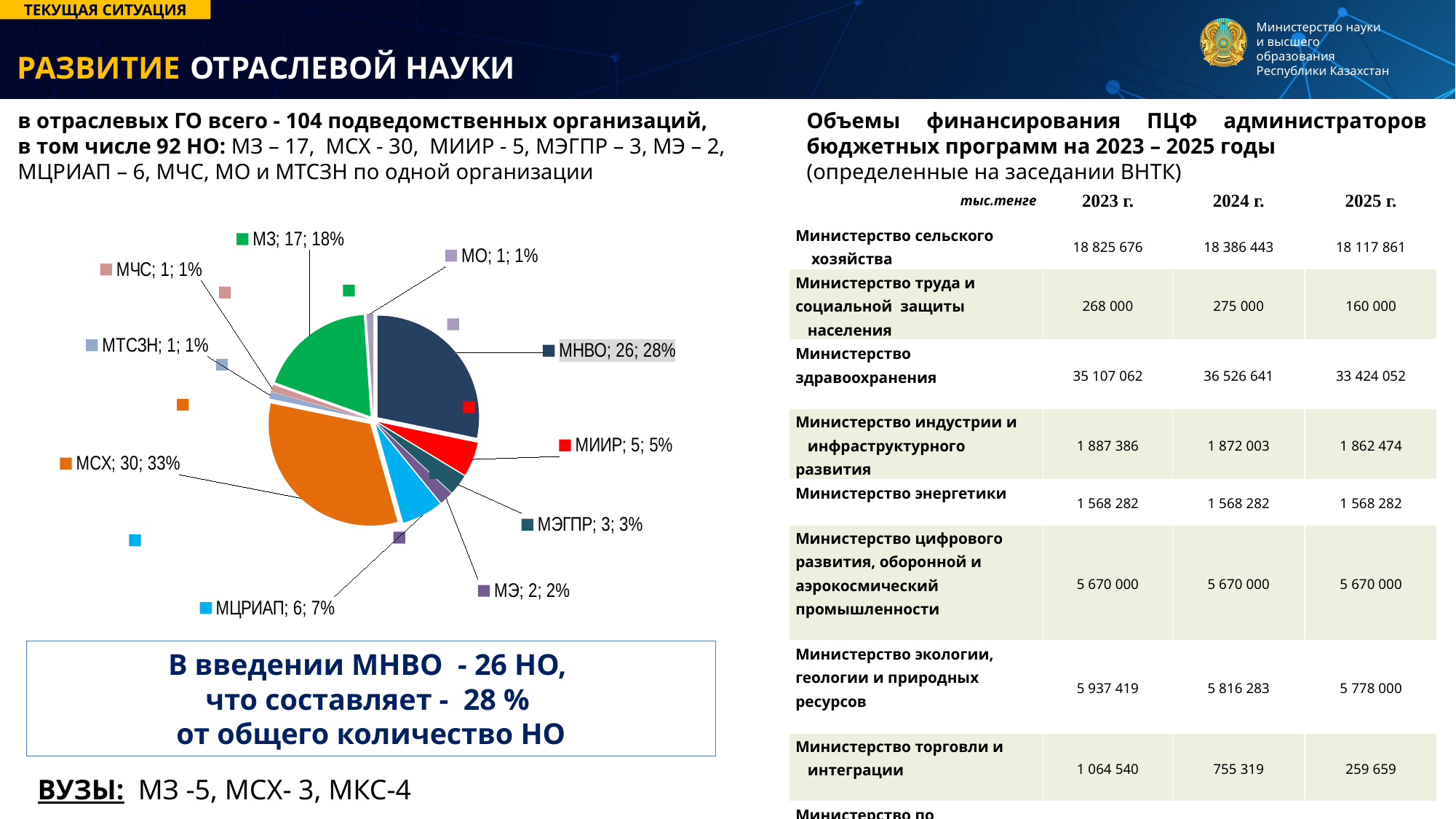
What colour is the МСХ slice in the pie chart? orange What percentage share does МЗ have in the pie chart? 18% What percentage share does МЦРИАП have in the pie chart? 7% Which is larger in the pie chart, МИИР or МЭГПР? МИИР What percentage share does МНВО have in the pie chart? 28% What kind of chart is shown on the left side of the slide? pie chart What is the value shown for МЭ in the pie chart? 2 What is the difference between the values for МСХ and МНВО in the pie chart? 4 How many categories (slices) does the pie chart have? 10 Which category has the largest slice in the pie chart? МСХ What is the value shown for МСХ in the pie chart? 30 What is the value shown for МЗ in the pie chart? 17